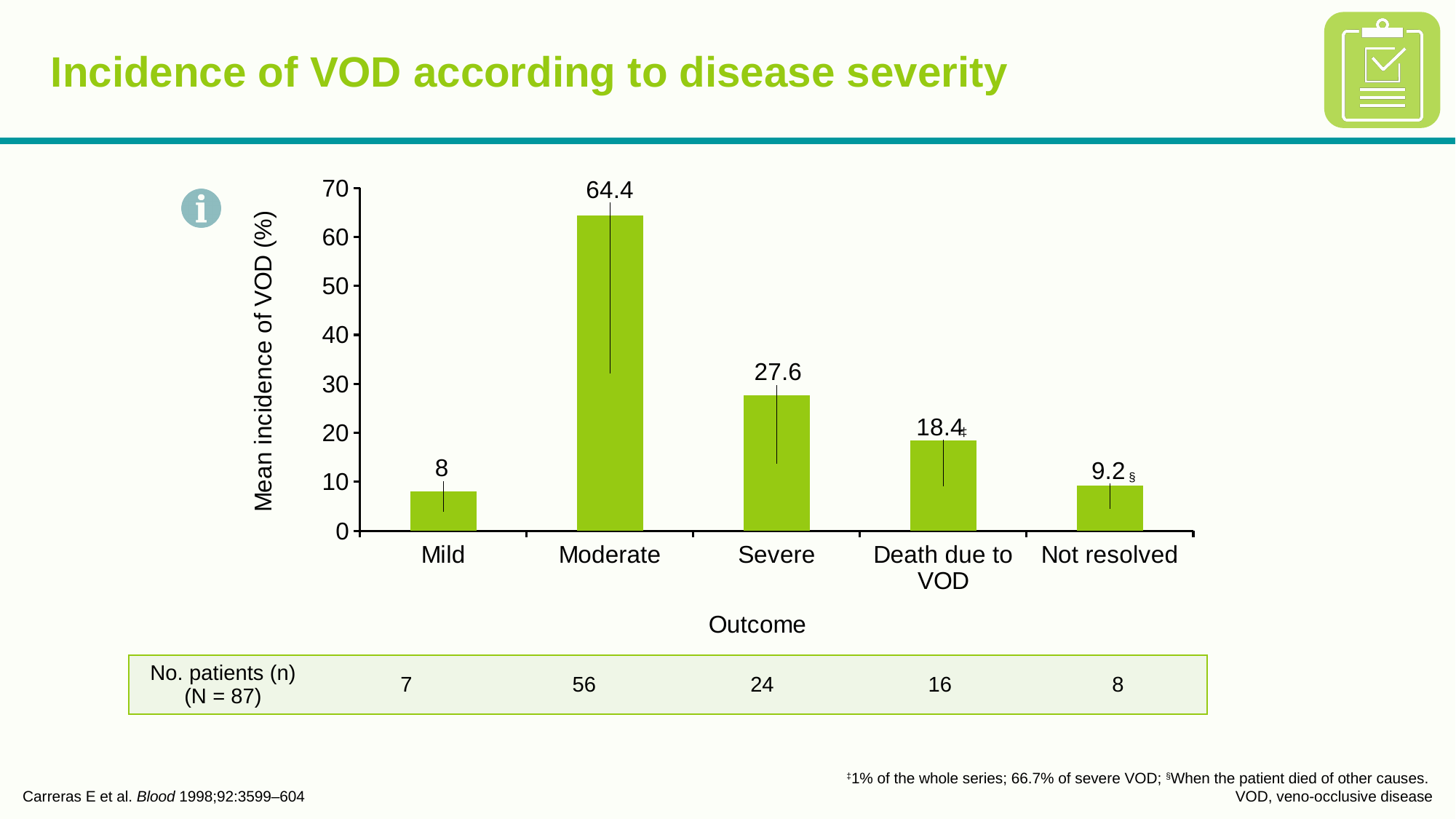
How many outcome categories are shown on the x axis? 5 Which outcome has the lowest mean incidence of VOD? Mild Which has a larger mean incidence of VOD, Severe or Death due to VOD? Severe Is the mean incidence of VOD for Moderate greater or less than 60? greater What kind of chart is shown on the slide? Bar chart What is the mean incidence of VOD (%) for Death due to VOD? 18.4 What is the label of the y axis? Mean incidence of VOD (%) Which outcome has the highest mean incidence of VOD? Moderate What is the mean incidence of VOD (%) for the Severe outcome? 27.6 What is the mean incidence of VOD (%) for the Not resolved outcome? 9.2 What is the difference in mean incidence of VOD between Moderate and Severe? 36.8 What is the mean incidence of VOD (%) for the Moderate outcome? 64.4